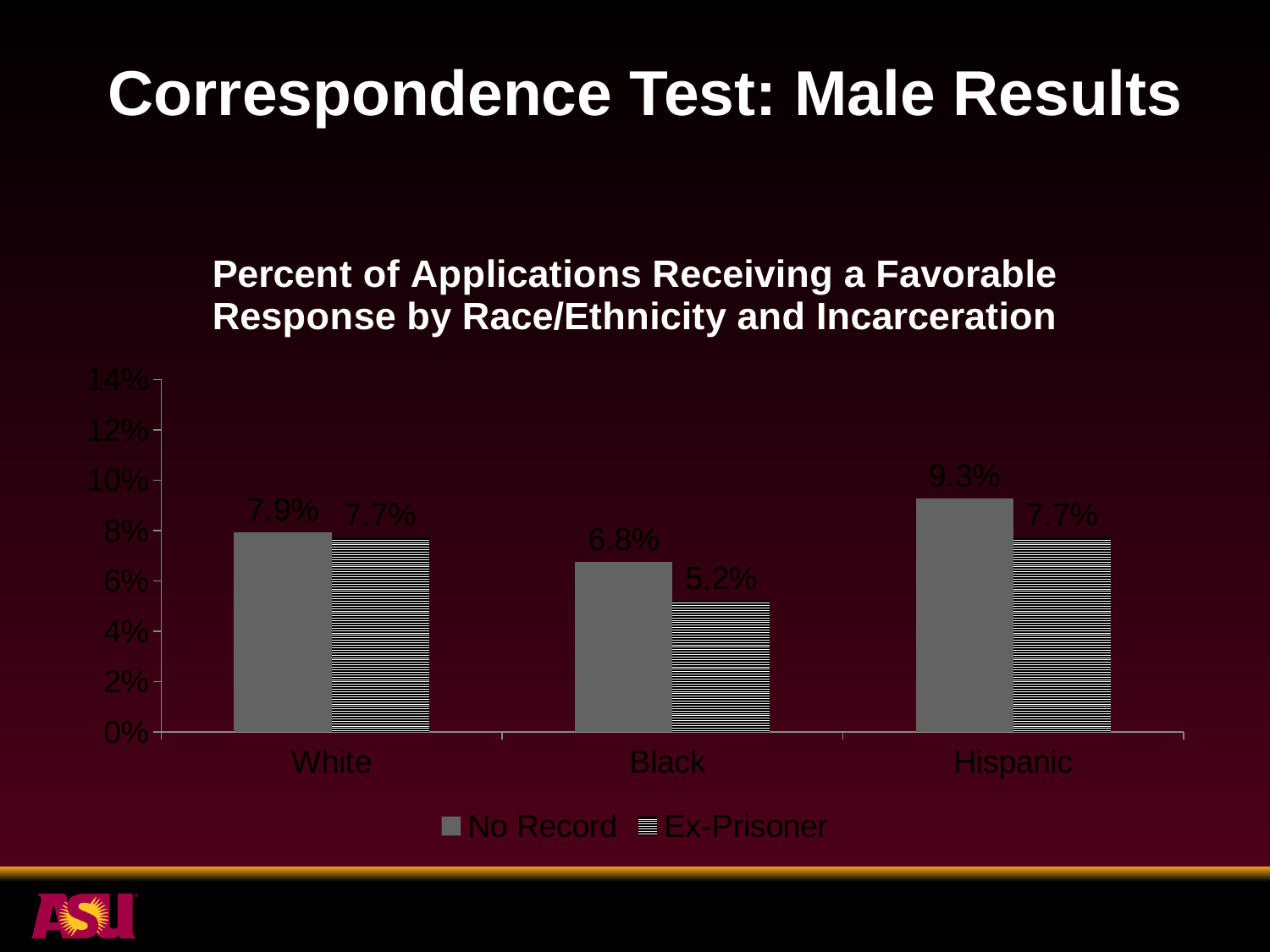
How many race/ethnicity categories are shown on the x axis? 3 Is the No Record value for Black greater or less than 8%? less What is the difference between the No Record and Ex-Prisoner values for Black? 1.6% Which is larger, the Ex-Prisoner value for White or the Ex-Prisoner value for Black? White Which category has the lowest Ex-Prisoner value? Black What is the value for Ex-Prisoner in the Black category? 5.2% What kind of chart is shown on the slide? bar chart Which category has the highest No Record value? Hispanic What is the value for No Record in the Hispanic category? 9.3% What is the value for No Record in the White category? 7.9% How many series does the legend list? 2 What is the difference between the No Record and Ex-Prisoner values for Hispanic? 1.6%